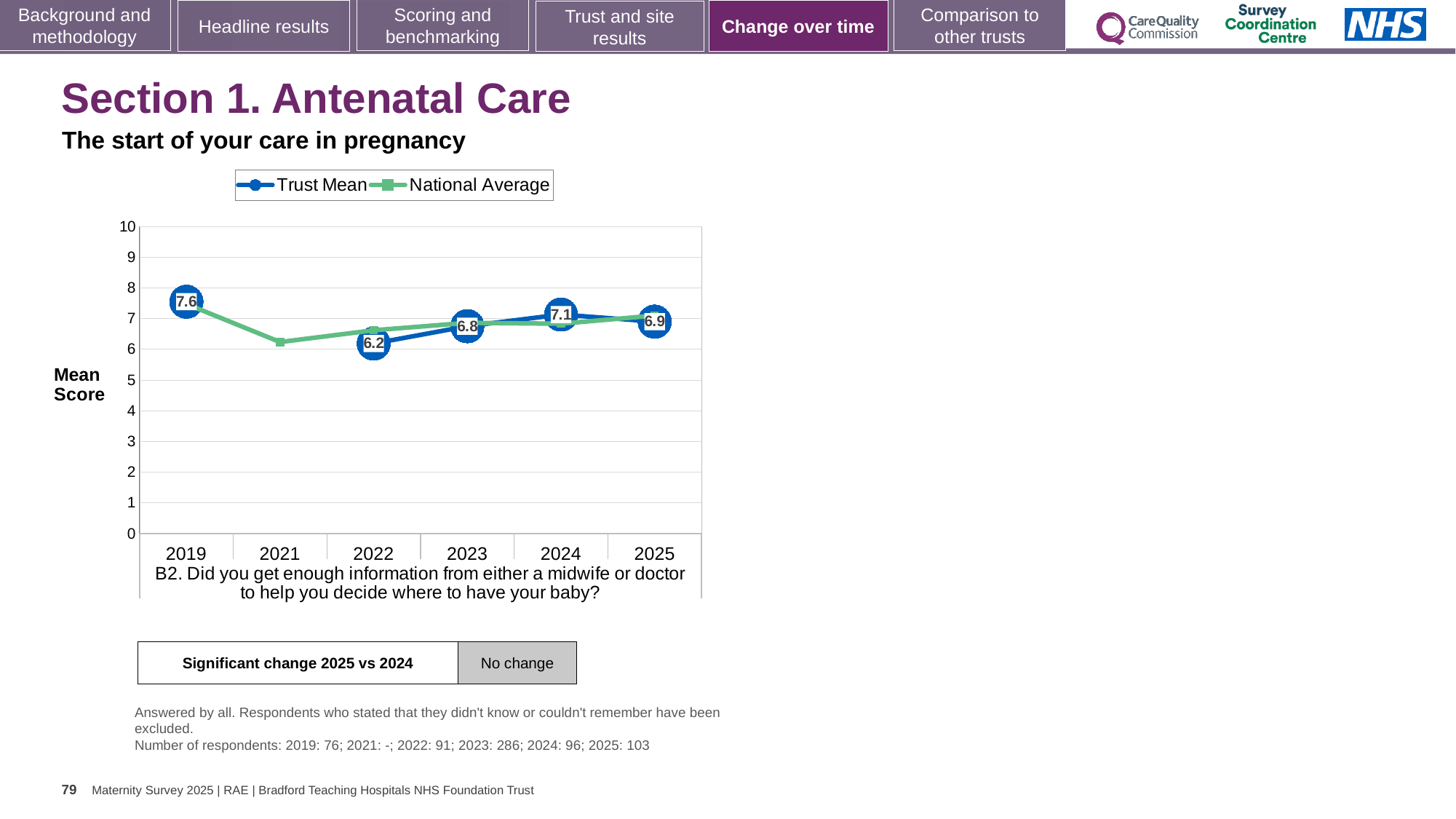
In which year is the Trust Mean highest? 2019 What is the Trust Mean value for 2022? 6.2 What is the Trust Mean value for 2025? 6.9 What is the Trust Mean value for 2019? 7.6 In which year is the Trust Mean lowest? 2022 How many years are shown on the x axis? 6 Does the Trust Mean rise or fall from 2022 to 2024? rise Which year has the larger Trust Mean, 2024 or 2025? 2024 Is the National Average value for 2021 greater or less than 7? less What kind of chart is shown on the slide? line chart What is the difference between the Trust Mean in 2019 and in 2022? 1.4 How many series does the legend list? 2